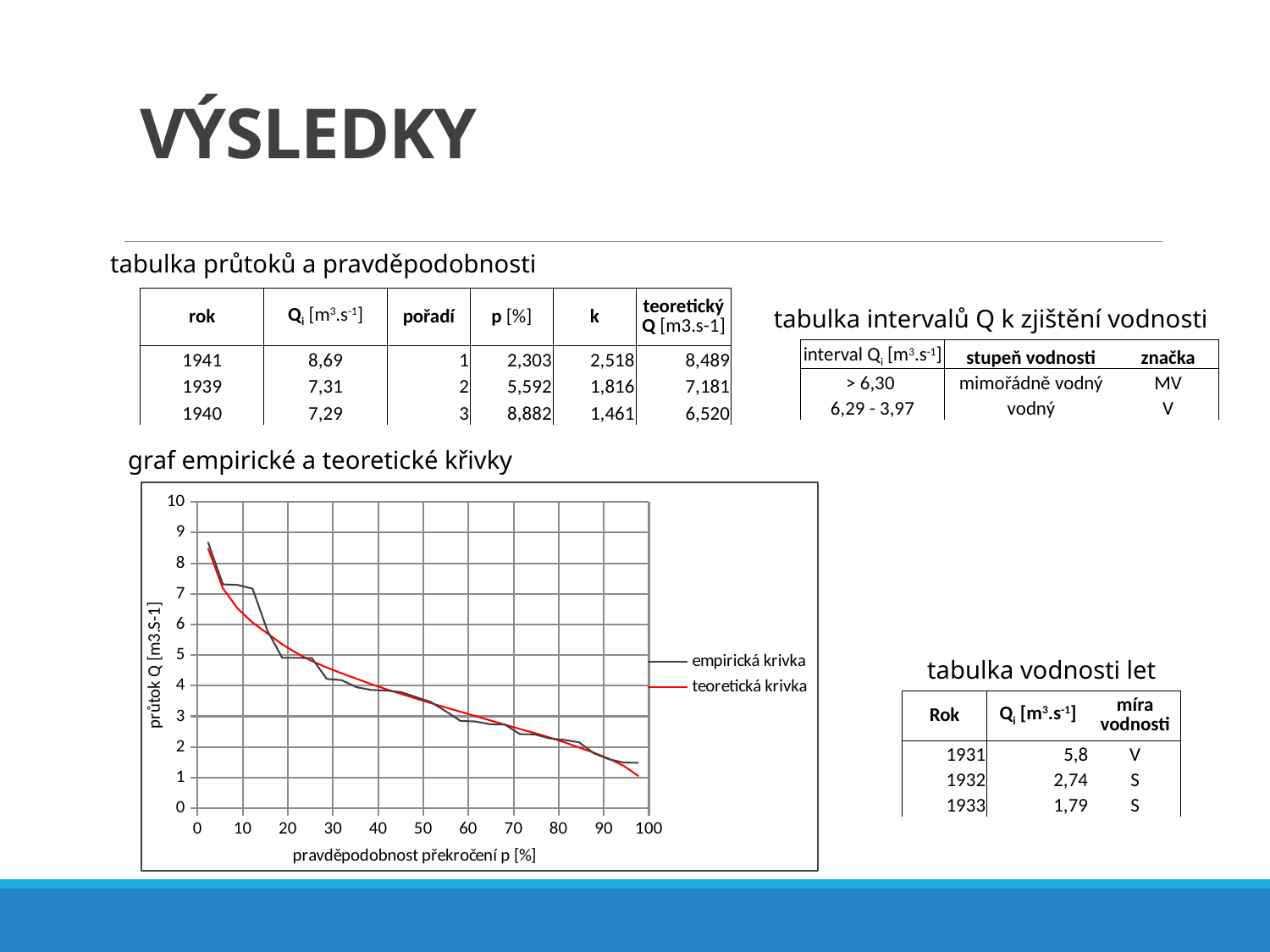
What is the label of the x axis of the chart? pravděpodobnost překročení p [%] Is the value of the empirická krivka at p = 10 % greater or less than 6? greater What is the highest value shown on the y axis of the chart? 10 What kind of chart is shown on the slide? line chart Do the values of the empirická krivka rise or fall as p increases along the x axis? fall Is the value of the empirická krivka at p = 90 % greater or less than 3? less Is the value of the teoretická krivka at p = 30 % greater or less than 3? greater How many series does the chart legend list? 2 What are the two series named in the chart legend? empirická krivka, teoretická krivka Do the values of the teoretická krivka rise or fall as p increases along the x axis? fall